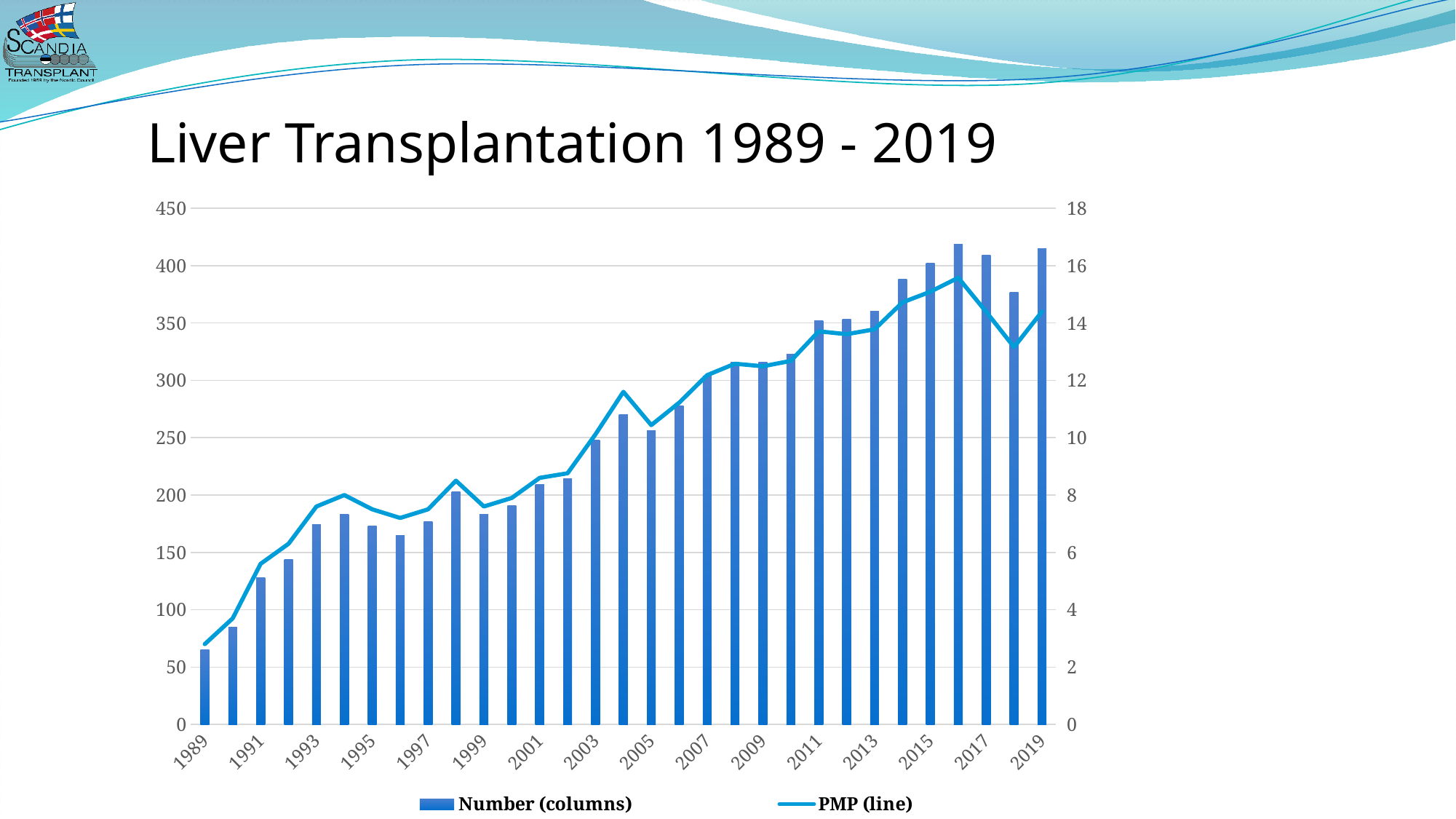
How many years (bars) are plotted on the chart? 31 Which year has the larger Number (columns) value, 2016 or 2018? 2016 Is the Number (columns) value for 2016 greater or less than 400? greater How many series does the legend list? 2 Which year has the highest bar for Number (columns)? 2016 Overall, do the Number (columns) values rise or fall from 1989 to 2019? Rise In which year does the PMP (line) reach its highest point? 2016 Is the PMP (line) value for 2016 greater or less than 14? greater Is the Number (columns) value for 2018 greater or less than 400? less Which year has the lowest bar for Number (columns)? 1989 What kind of chart is shown on the slide? A combined bar and line chart